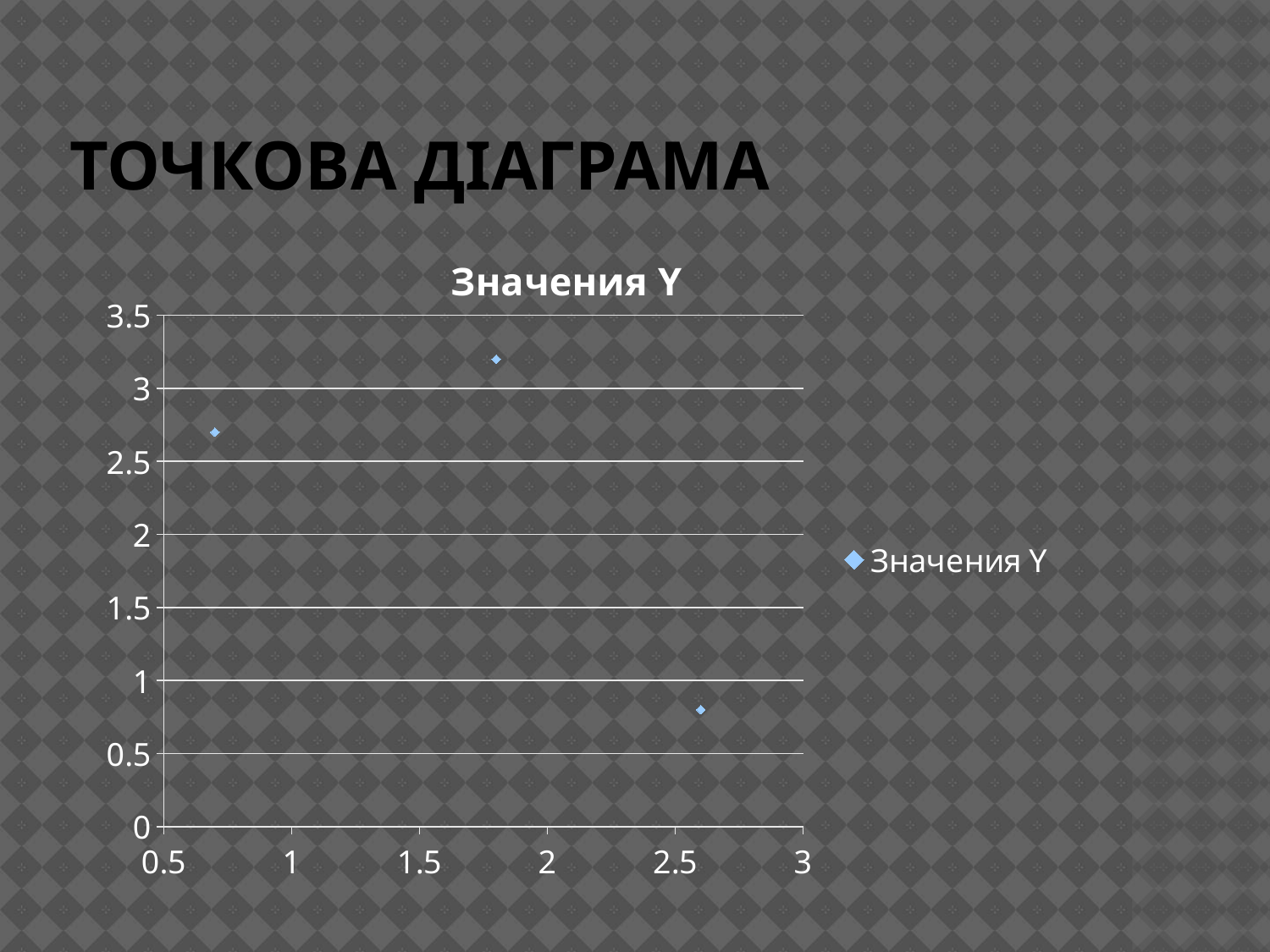
What kind of chart is shown on the slide? Scatter chart What is the name of the series shown in the legend? Значения Y Which has the larger y value: the point near x = 0.7 or the point near x = 2.6? The point near x = 0.7 Which point has the highest y value: the one near x = 0.7, x = 1.8, or x = 2.6? The point near x = 1.8 Does the y value rise or fall from the point near x = 1.8 to the point near x = 2.6? fall Is the y value of the point near x = 1.8 greater or less than 3? greater How many data points are plotted on the chart? 3 How many series does the legend list? 1 Which point has the lowest y value: the one near x = 0.7, x = 1.8, or x = 2.6? The point near x = 2.6 What is the title of the chart? Значения Y Is the y value of the point near x = 2.6 greater or less than 1? less Is the y value of the point near x = 0.7 greater or less than 2.5? greater